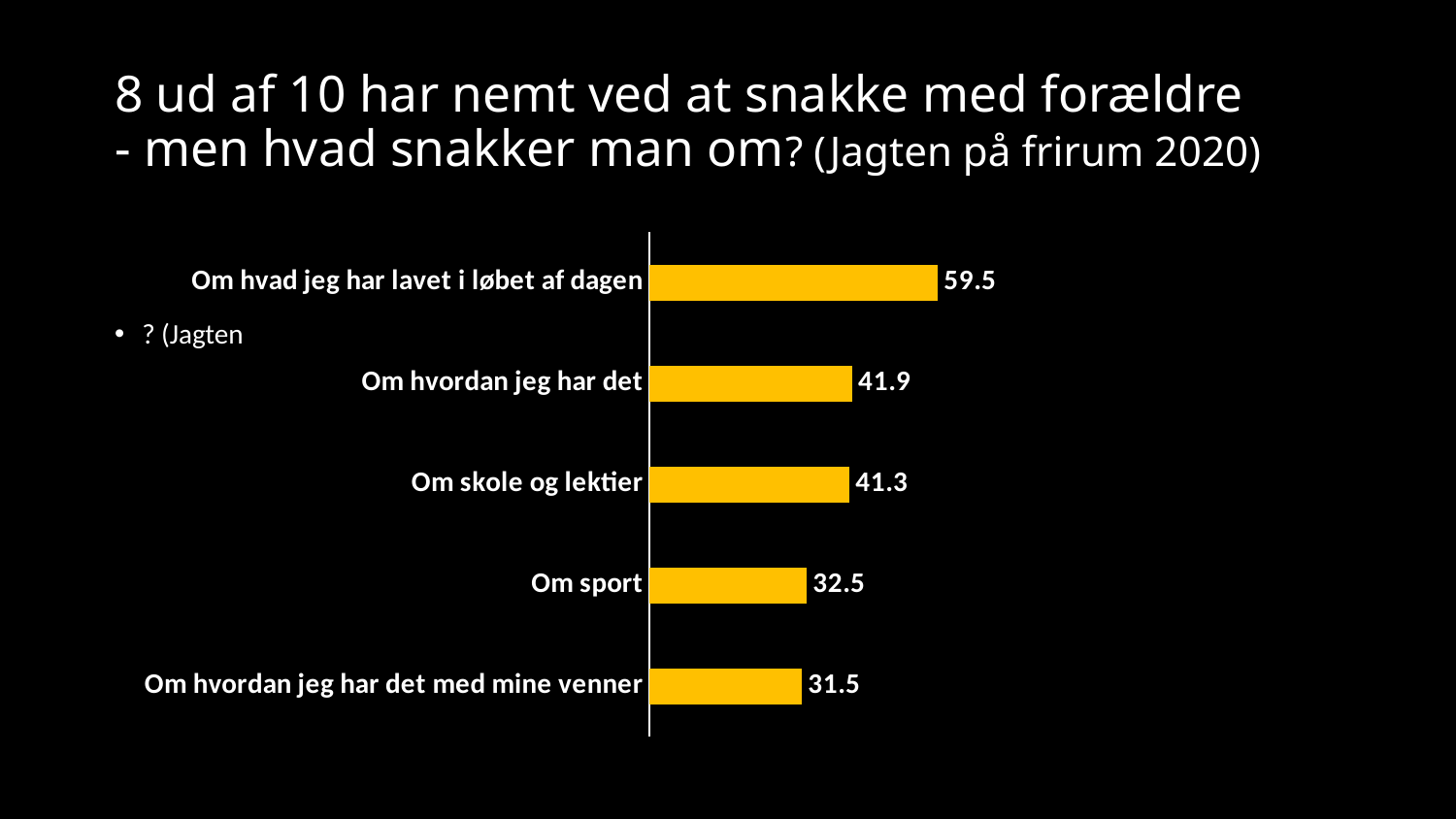
Which is larger, the value for "Om sport" or the value for "Om hvordan jeg har det med mine venner"? Om sport What is the value for "Om sport"? 32.5 What is the value for "Om hvad jeg har lavet i løbet af dagen"? 59.5 What kind of chart is shown on the slide? Bar chart What is the difference between the values for "Om hvad jeg har lavet i løbet af dagen" and "Om sport"? 27.0 What is the value for "Om hvordan jeg har det med mine venner"? 31.5 Which category has the lowest value? Om hvordan jeg har det med mine venner What is the value for "Om hvordan jeg har det"? 41.9 How many categories are shown in the chart? 5 What is the difference between the values for "Om hvordan jeg har det" and "Om skole og lektier"? 0.6 Which category has the highest value? Om hvad jeg har lavet i løbet af dagen What is the value for "Om skole og lektier"? 41.3